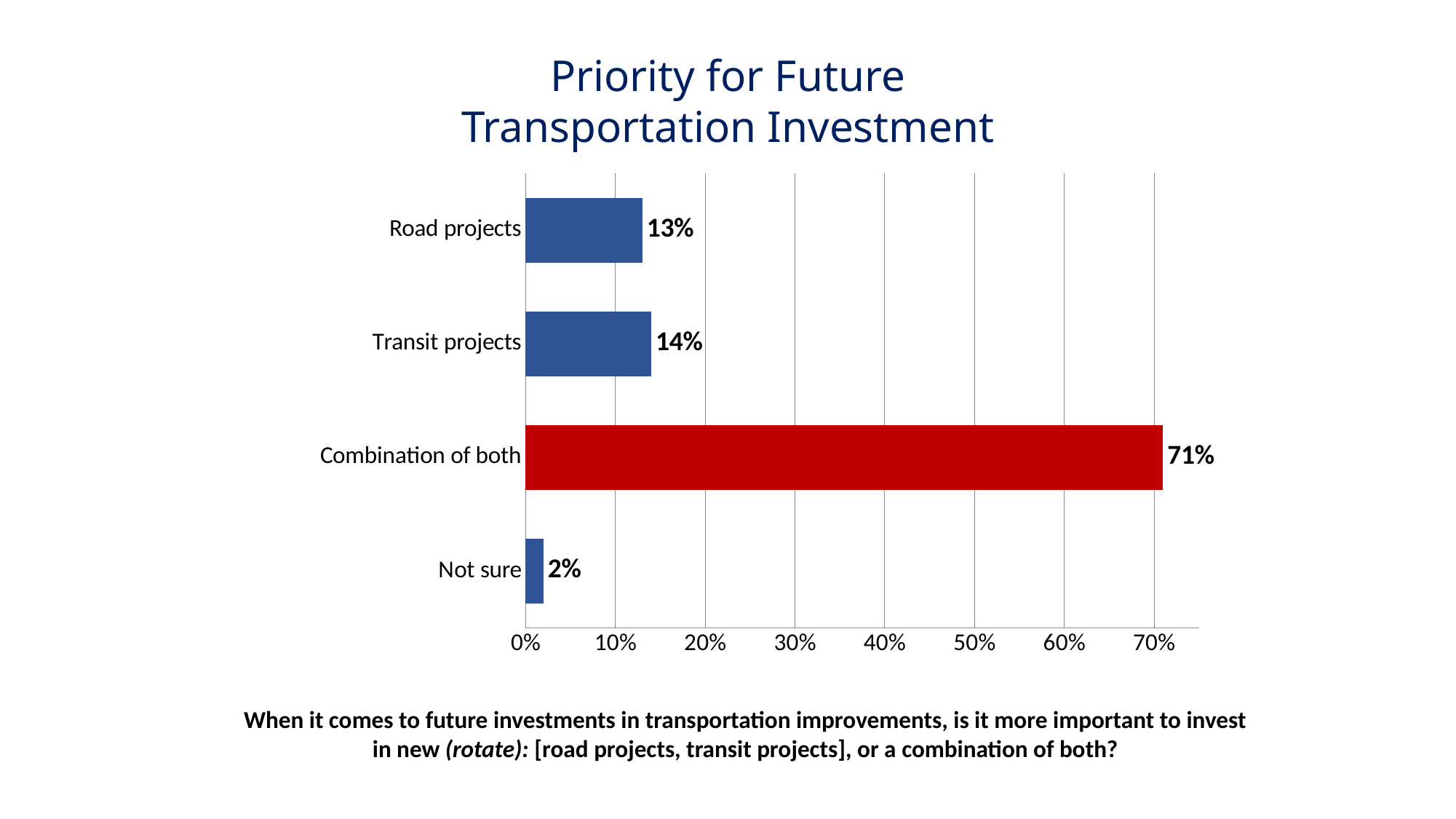
Which is larger, the value for Combination of both or the value for Road projects? Combination of both What is the difference between the values for Combination of both and Transit projects? 57% Is the value for Combination of both greater or less than 60%? greater What is the difference between the values for Transit projects and Road projects? 1% What is the value for Not sure? 2% Which category has the lowest value? Not sure What is the value for Combination of both? 71% What kind of chart is shown on the slide? Bar chart Which category has the highest value? Combination of both What is the value for Transit projects? 14% How many categories are shown in the chart? 4 What is the value for Road projects? 13%